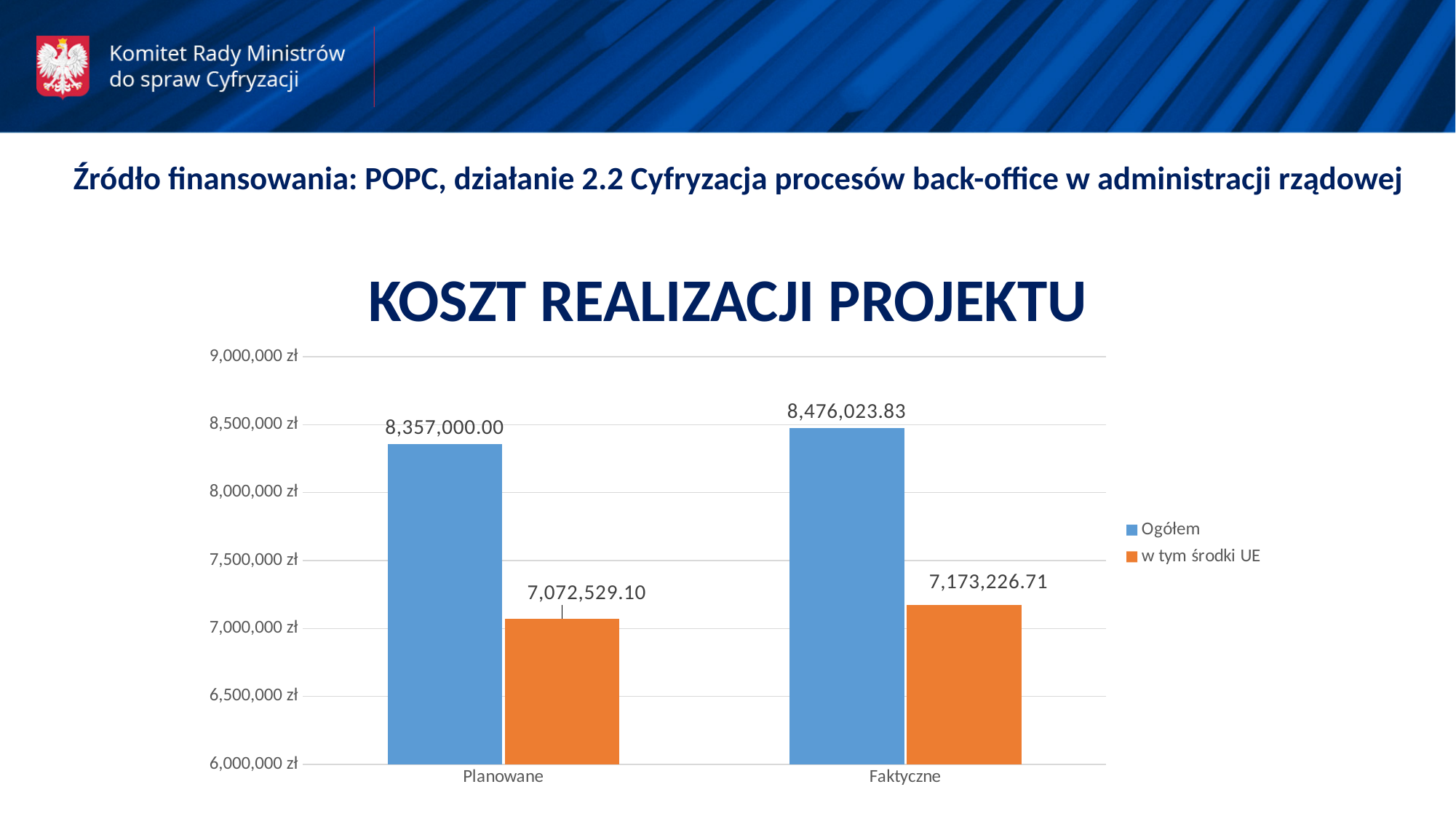
What is the difference between Ogółem and 'w tym środki UE' for Planowane? 1,284,470.90 How many series does the legend list? 2 What is the Ogółem value for Faktyczne? 8,476,023.83 What is the 'w tym środki UE' value for Faktyczne? 7,173,226.71 Which category has the higher Ogółem value, Planowane or Faktyczne? Faktyczne What kind of chart is shown on the slide? Bar chart What is the Ogółem value for Planowane? 8,357,000.00 What is the difference between the Ogółem values for Faktyczne and Planowane? 119,023.83 What is the difference between the 'w tym środki UE' values for Faktyczne and Planowane? 100,697.61 What is the title of the chart? KOSZT REALIZACJI PROJEKTU What is the 'w tym środki UE' value for Planowane? 7,072,529.10 How many categories are shown on the x axis? 2